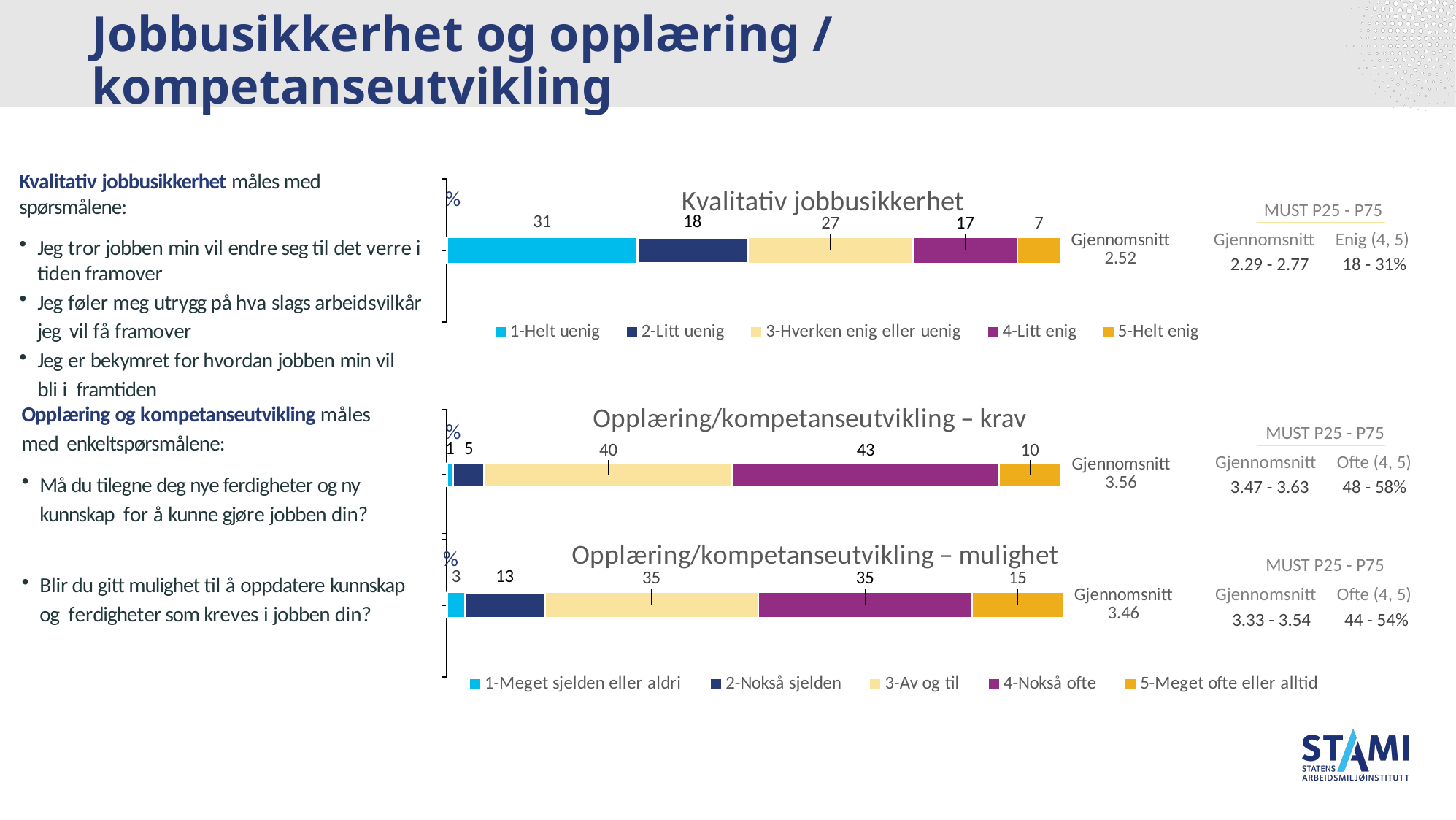
In the 'Opplæring/kompetanseutvikling – mulighet' chart, what percentage is shown for '5-Meget ofte eller alltid'? 15 In the 'Opplæring/kompetanseutvikling – mulighet' chart, which is larger: the value for '2-Nokså sjelden' or the value for '5-Meget ofte eller alltid'? 5-Meget ofte eller alltid In the 'Kvalitativ jobbusikkerhet' chart, which response category has the smallest share? 5-Helt enig In the 'Kvalitativ jobbusikkerhet' chart, what is the difference between the '1-Helt uenig' and '2-Litt uenig' values? 13 What kind of chart is 'Kvalitativ jobbusikkerhet'? Stacked bar chart In the 'Opplæring/kompetanseutvikling – krav' chart, which response category has the largest share? 4-Nokså ofte What is the 'Gjennomsnitt' value shown next to the 'Opplæring/kompetanseutvikling – mulighet' chart? 3.46 In the 'Opplæring/kompetanseutvikling – krav' chart, what percentage is shown for '4-Nokså ofte'? 43 In the 'Kvalitativ jobbusikkerhet' chart, what percentage is shown for '1-Helt uenig'? 31 In the 'Opplæring/kompetanseutvikling – krav' chart, what is the total of all the segments in the stacked bar? 99 In the 'Opplæring/kompetanseutvikling – mulighet' chart, what is the difference between the '3-Av og til' and '1-Meget sjelden eller aldri' values? 32 In the 'Kvalitativ jobbusikkerhet' chart, how many series does the legend list? 5